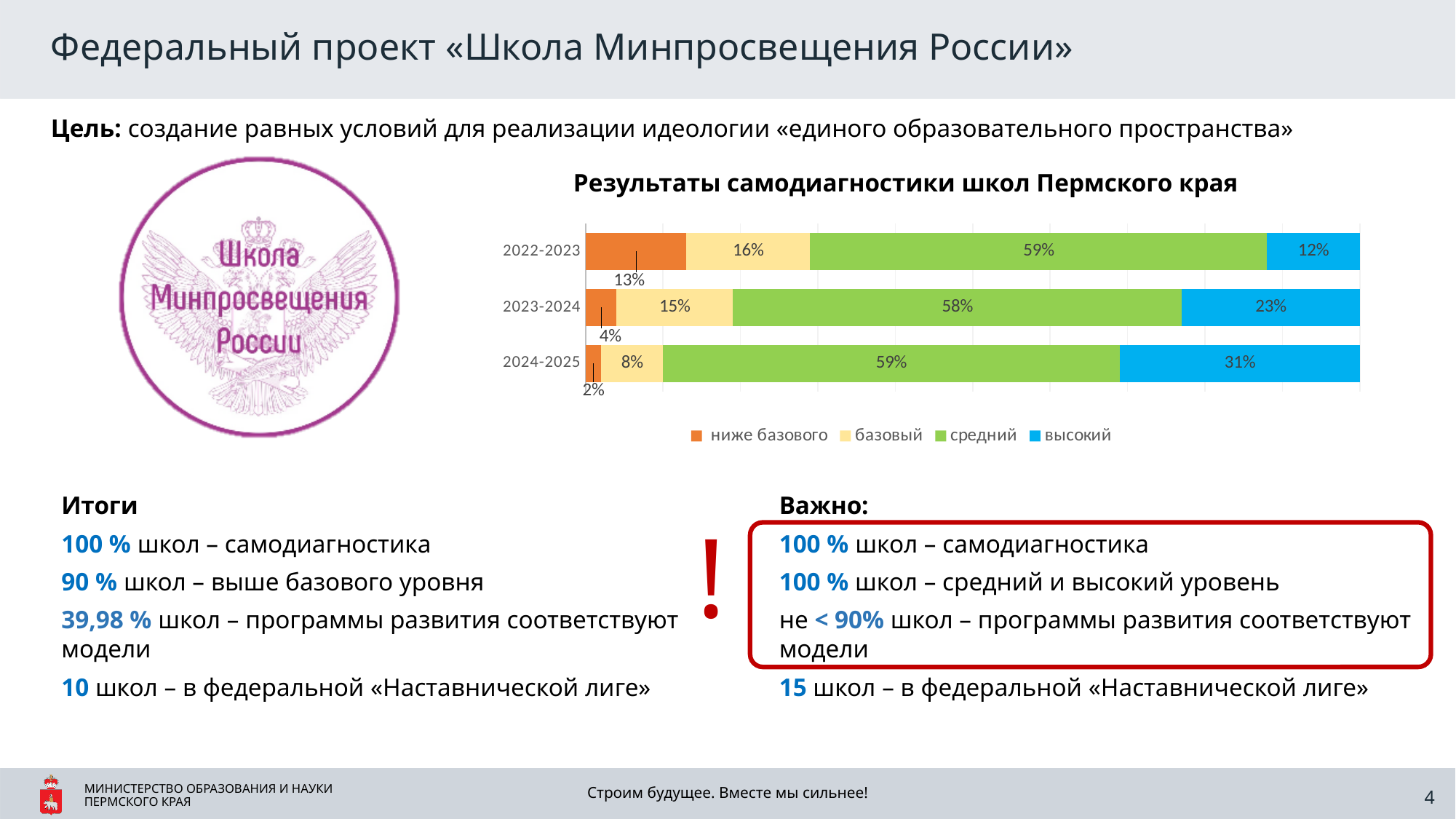
В каком учебном году доля школ ниже базового уровня наименьшая? 2024-2025 Какова доля школ с высоким уровнем в 2024-2025 году? 31% Каким цветом на диаграмме обозначен ряд «средний»? Зелёным Какой тип диаграммы показан на слайде «Результаты самодиагностики школ Пермского края»? Столбчатая диаграмма с накоплением (горизонтальная) Что больше: доля школ с базовым уровнем в 2022-2023 году или в 2024-2025 году? 2022-2023 Какова доля школ ниже базового уровня в 2022-2023 году? 13% Сколько рядов данных перечислено в легенде диаграммы? 4 Сколько учебных годов (категорий) показано на диаграмме? 3 В каком учебном году доля школ с высоким уровнем наибольшая? 2024-2025 Какова доля школ с базовым уровнем в 2023-2024 году? 15% На сколько процентных пунктов доля школ с высоким уровнем в 2024-2025 году больше, чем в 2022-2023 году? 19 Как меняется доля школ с высоким уровнем от 2022-2023 к 2024-2025 году? Растёт